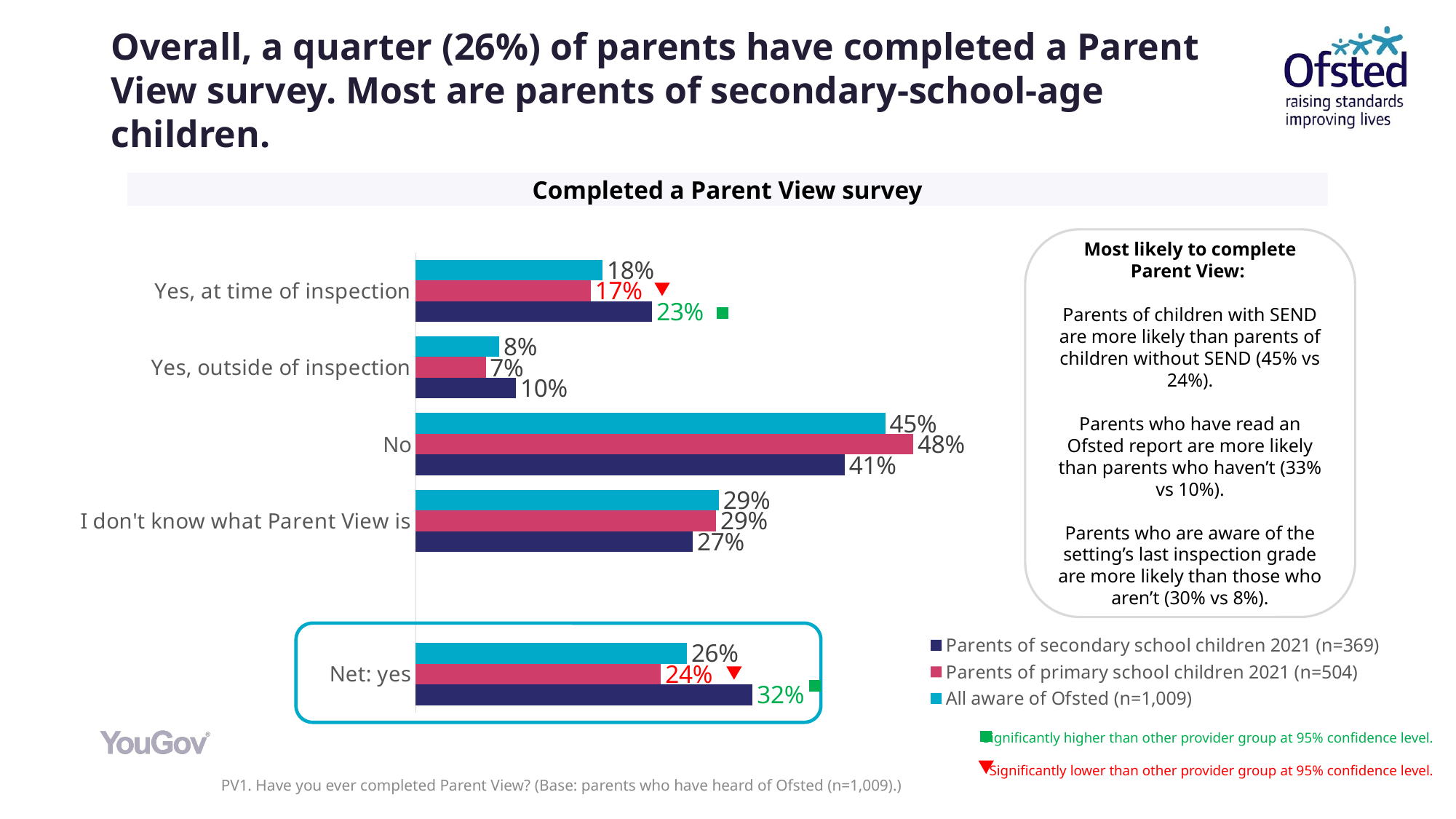
How many series does the legend list? 3 For 'I don't know what Parent View is', which is larger: the value for All aware of Ofsted or for parents of secondary school children? All aware of Ofsted What is the difference between the 'Net: yes' values for parents of secondary school children and parents of primary school children? 8 percentage points What is the title of the chart? Completed a Parent View survey What is the 'Net: yes' value for All aware of Ofsted? 26% What type of chart is shown on the slide? Bar chart What percentage of parents of secondary school children said 'Yes, at time of inspection'? 23% What percentage of parents of primary school children answered 'No'? 48% Which series has the highest 'Net: yes' value? Parents of secondary school children 2021 (n=369) How many response categories are shown on the chart? 5 Which series has the lowest value for 'No'? Parents of secondary school children 2021 (n=369) What is the value for 'Yes, outside of inspection' among parents of secondary school children? 10%